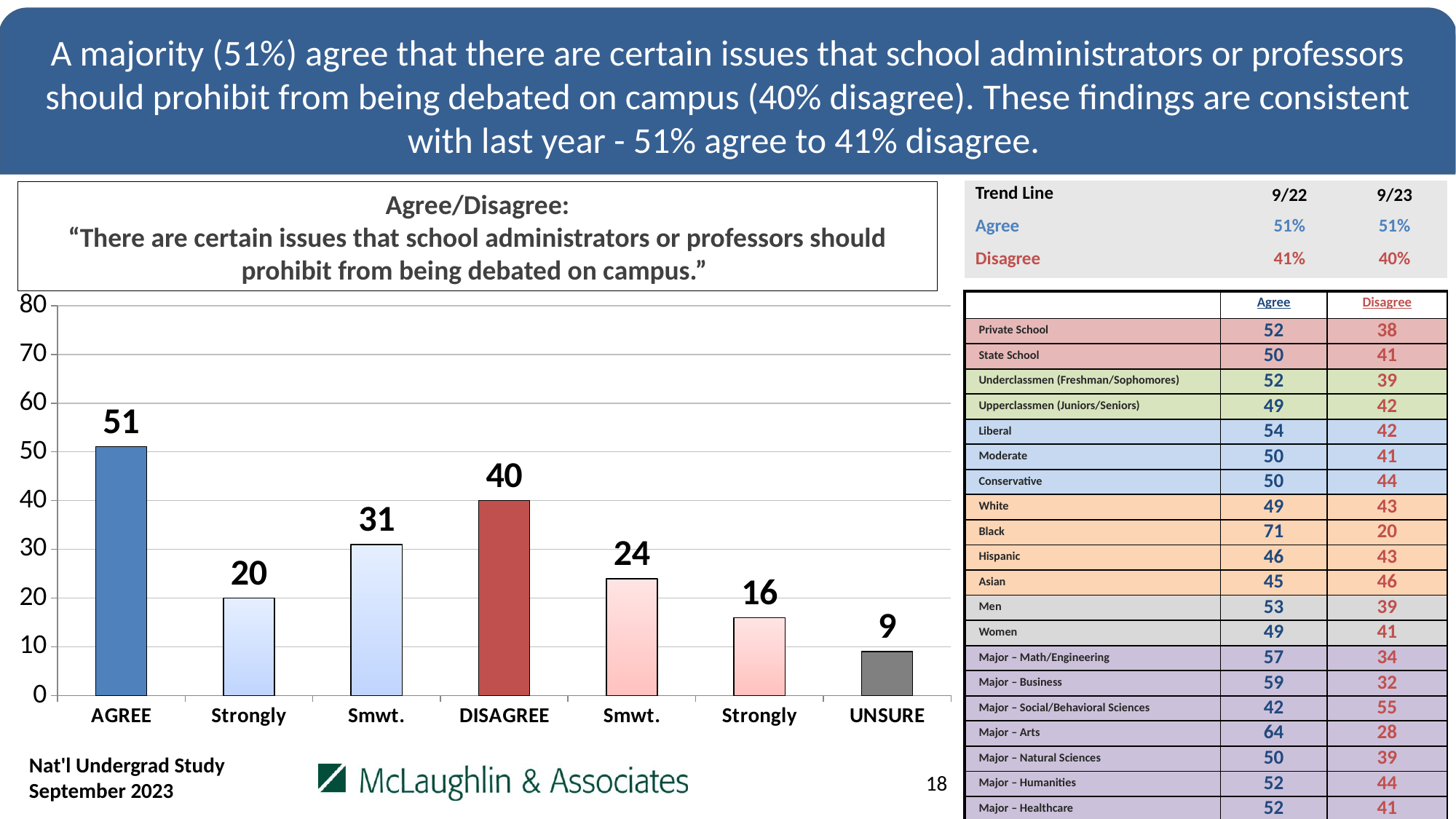
What value is shown for the UNSURE bar? 9 Which is larger, the Strongly bar next to AGREE (second bar) or the Smwt. bar next to DISAGREE (fifth bar)? Smwt. (24) What kind of chart is shown on the slide? Bar chart What is the difference between the AGREE and DISAGREE values? 11 Which category has the lowest bar? UNSURE What value is shown for the Smwt. bar immediately to the right of AGREE? 31 How many bars are plotted in the chart? 7 What value is shown for the Strongly bar immediately to the right of DISAGREE's Smwt. bar (the sixth bar)? 16 What value is shown for the DISAGREE bar? 40 What value is shown for the AGREE bar? 51 What is the highest value shown on the chart's vertical axis? 80 Which category has the highest bar? AGREE